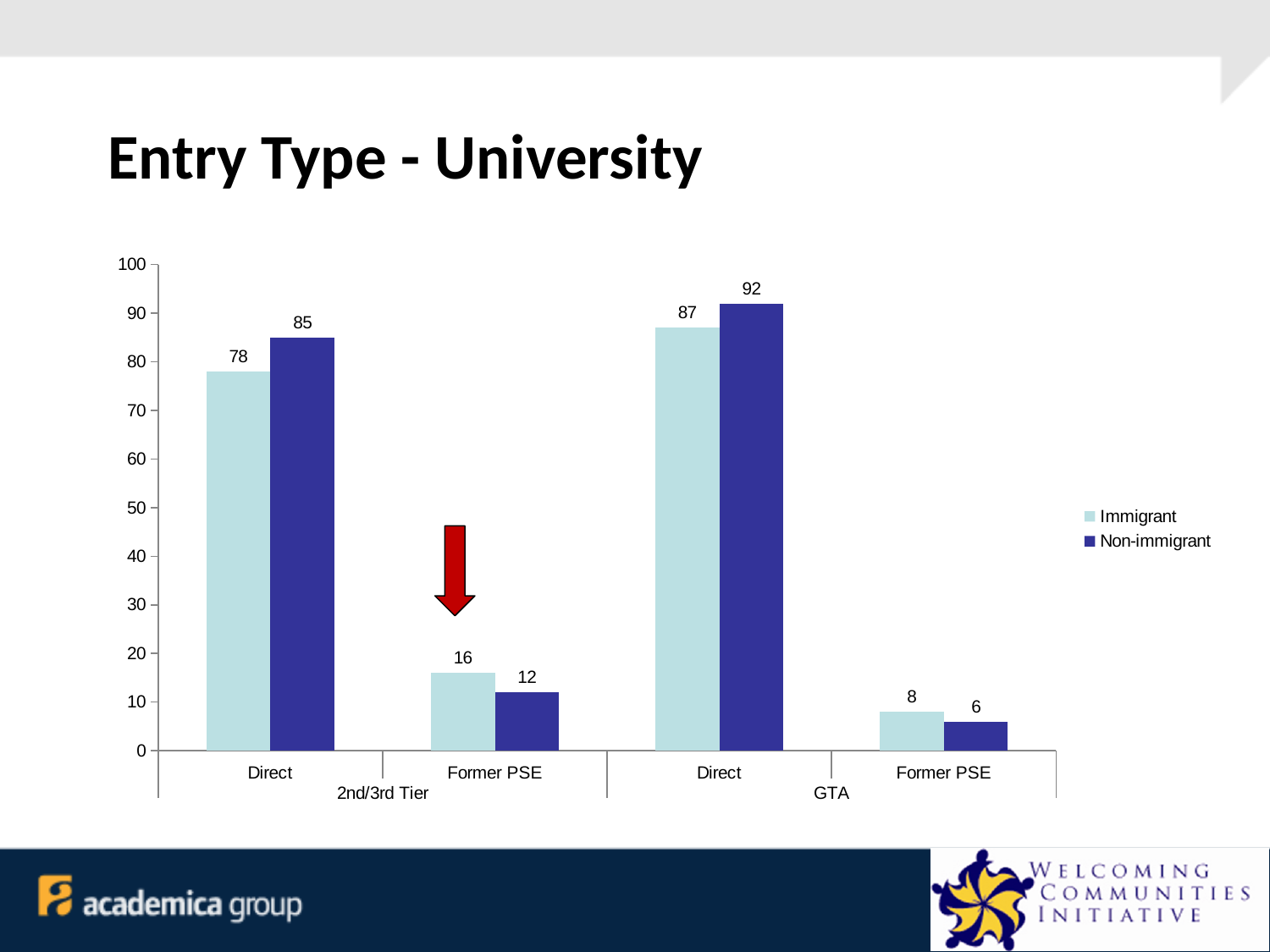
Which bar has the lowest value on the chart? Non-immigrant, Former PSE, GTA Which bar has the highest value on the chart? Non-immigrant, Direct, GTA For Former PSE in the 2nd/3rd Tier group, which is larger: the Immigrant value or the Non-immigrant value? Immigrant What is the title of the slide? Entry Type - University What is the Immigrant value for Direct entry in the 2nd/3rd Tier group? 78 What is the Immigrant value for Former PSE in the GTA group? 8 How many series does the legend list? 2 What is the Non-immigrant value for Former PSE in the 2nd/3rd Tier group? 12 Is the Immigrant value for Direct entry in the GTA group greater or less than 80? greater What is the Non-immigrant value for Direct entry in the GTA group? 92 What kind of chart is shown on the slide? Bar chart What is the difference between the Non-immigrant and Immigrant values for Direct entry in the 2nd/3rd Tier group? 7